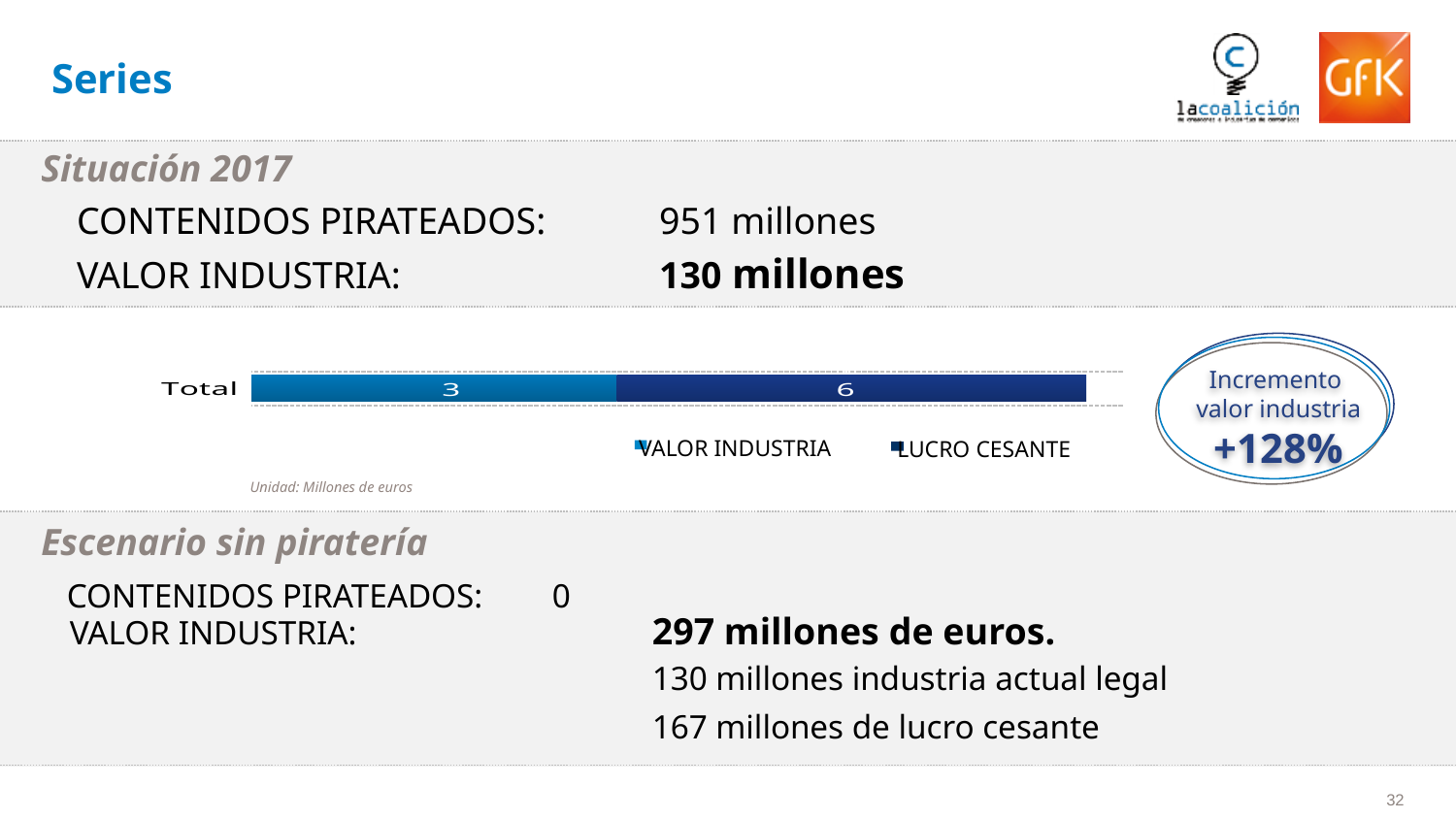
What is the total of the stacked Total bar? 297 How many series does the chart legend list? 2 What unit does the chart note say the values are in? Millones de euros Which series has the largest segment in the Total bar? LUCRO CESANTE What is the label of the single category in the chart? Total Which series has the smallest segment in the Total bar? VALOR INDUSTRIA Which series has the larger value in the Total bar, VALOR INDUSTRIA or LUCRO CESANTE? LUCRO CESANTE How many categories are plotted in the chart? 1 What is the value of the LUCRO CESANTE segment in the Total bar? 167 What is the difference between the LUCRO CESANTE and VALOR INDUSTRIA values in the Total bar? 37 What type of chart is shown on the slide? bar chart What is the value of the VALOR INDUSTRIA segment in the Total bar? 130